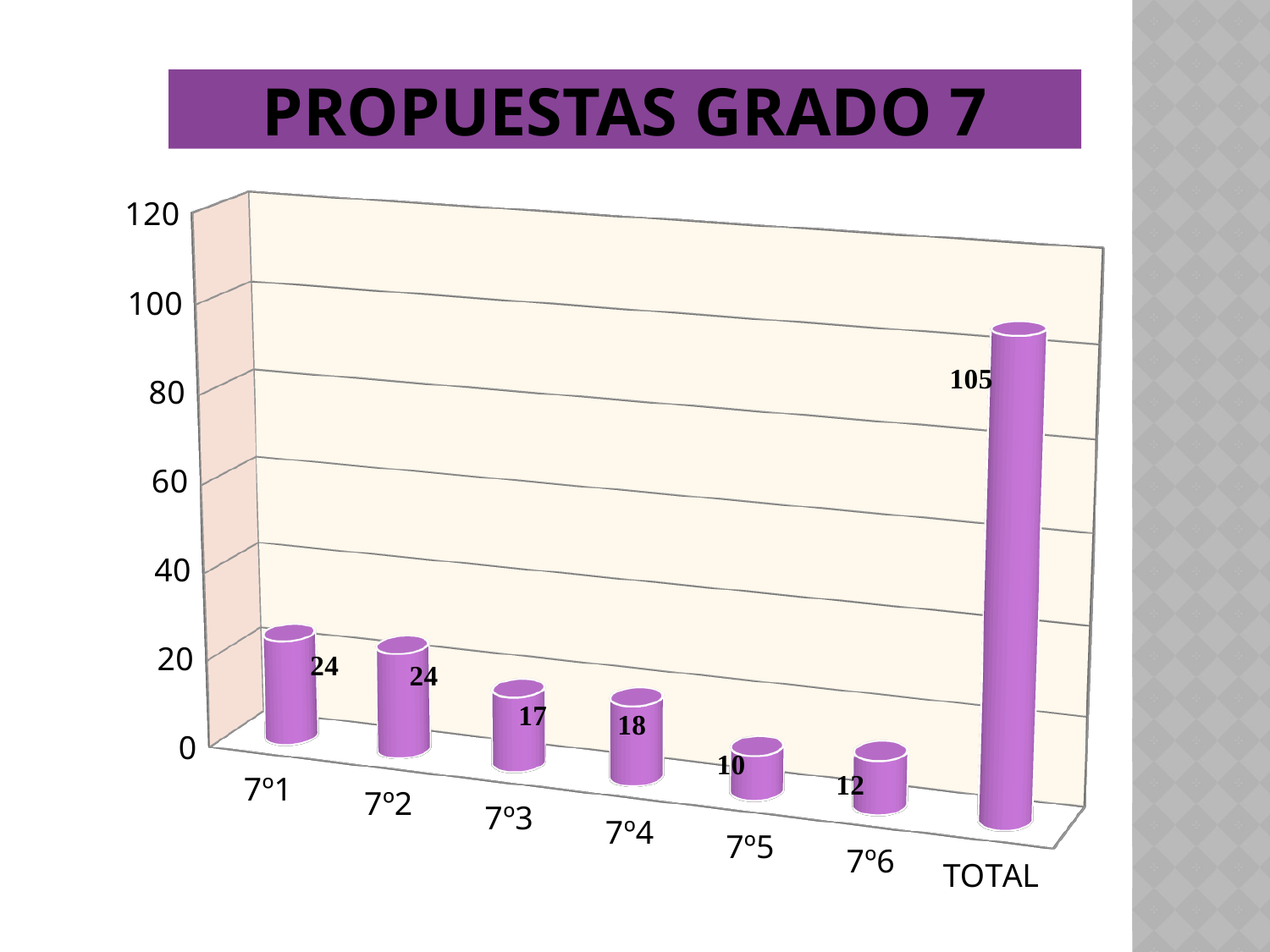
Is the value for TOTAL greater or less than 100? greater What is the value for 7º5? 10 Which is larger, the value for 7º4 or the value for 7º6? 7º4 What is the value for 7º6? 12 What kind of chart is shown on the slide? bar chart What is the value for 7º3? 17 What is the difference between the values for 7º1 and 7º3? 7 Which category has the lowest value? 7º5 What is the value for TOTAL? 105 How many categories are shown on the x axis? 7 Which category has the highest value? TOTAL What is the title of the slide? PROPUESTAS GRADO 7